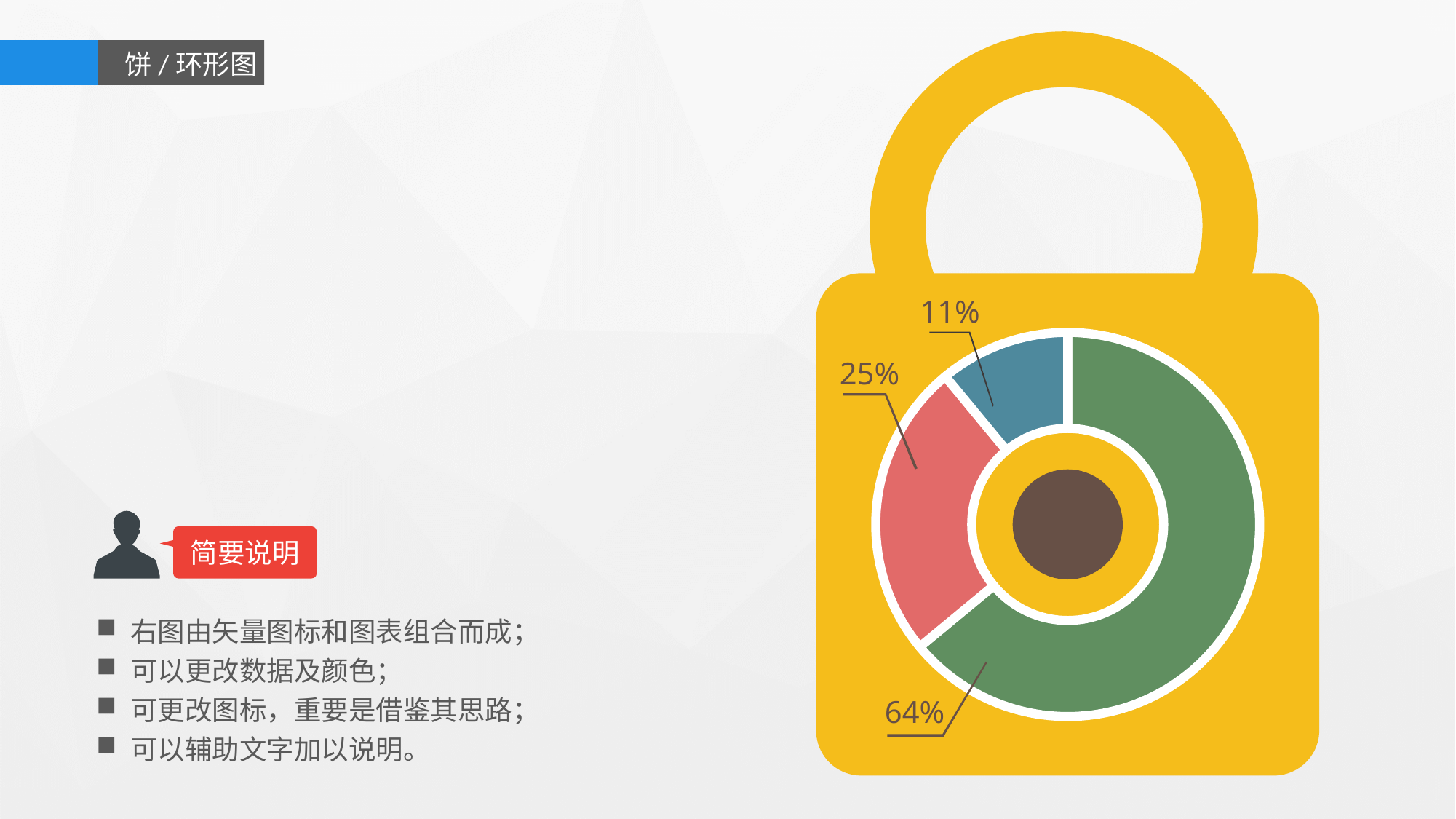
What colour is the circle at the centre of the doughnut chart? brown How many slices does the doughnut chart have? 3 Which slice of the doughnut chart has the largest share? the green slice (64%) What do the three percentage labels on the doughnut chart add up to? 100% What kind of chart is shown inside the lock icon on the slide? doughnut chart What percentage is shown for the blue slice of the doughnut chart? 11% Which slice of the doughnut chart has the smallest share? the blue slice (11%) What is the difference in percentage points between the red slice and the blue slice? 14 Which is larger, the red slice or the blue slice? the red slice What percentage is shown for the green slice of the doughnut chart? 64% What percentage is shown for the red slice of the doughnut chart? 25% What is the difference in percentage points between the green slice and the red slice? 39